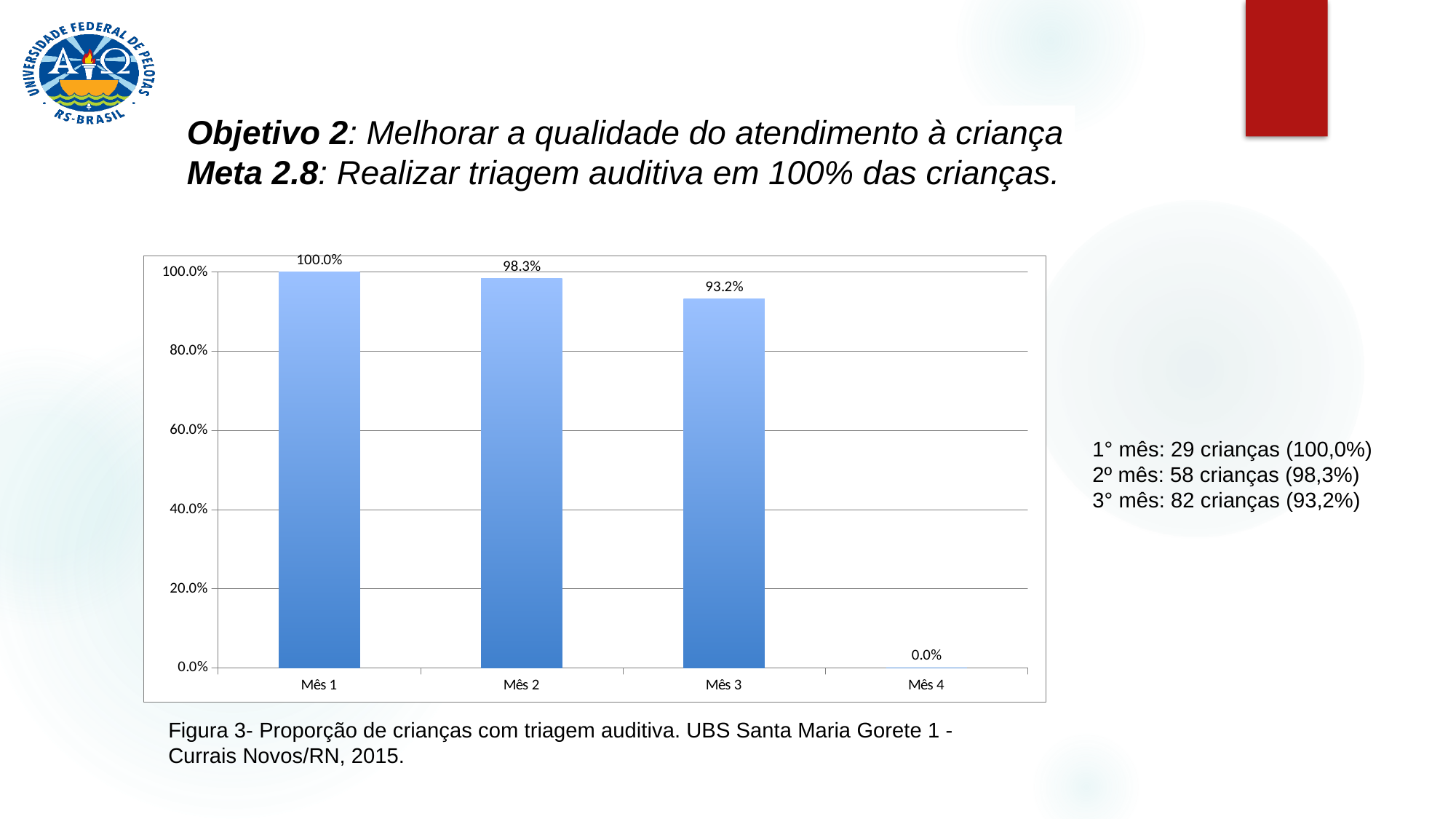
Do the values rise or fall from Mês 1 to Mês 4? fall What is the value for Mês 4? 0.0% What is the difference between the values for Mês 1 and Mês 3? 6.8% What is the value for Mês 1? 100.0% Which category has the lowest value? Mês 4 Is the value for Mês 3 greater or less than 80.0%? greater Which is larger, the value for Mês 2 or the value for Mês 3? Mês 2 Which category has the highest value? Mês 1 What is the value for Mês 2? 98.3% What kind of chart is shown on the slide? bar chart How many categories are shown on the x axis? 4 What is the value for Mês 3? 93.2%